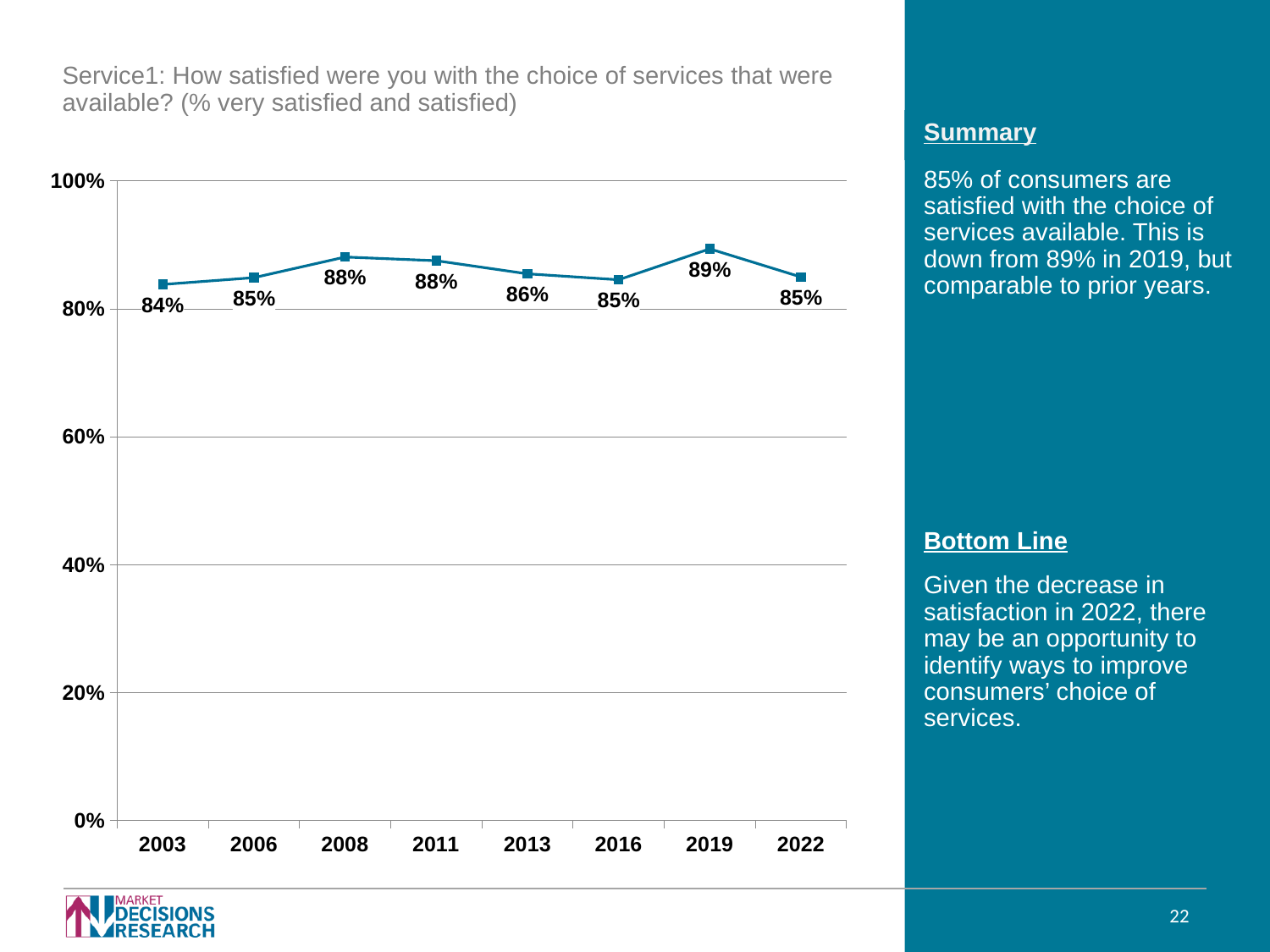
What was the satisfaction value in 2022? 85% What was the satisfaction value in 2003? 84% Which is larger, the value for 2008 or the value for 2013? 2008 Did the value rise or fall from 2019 to 2022? fall What is the highest value shown on the y axis? 100% How many years are plotted on the chart? 8 Which year has the lowest satisfaction value? 2003 What kind of chart is shown on the slide? line chart Is the value for 2016 greater or less than 80%? greater What is the difference between the 2019 value and the 2022 value? 4% Which year has the highest satisfaction value? 2019 What was the satisfaction value in 2019? 89%